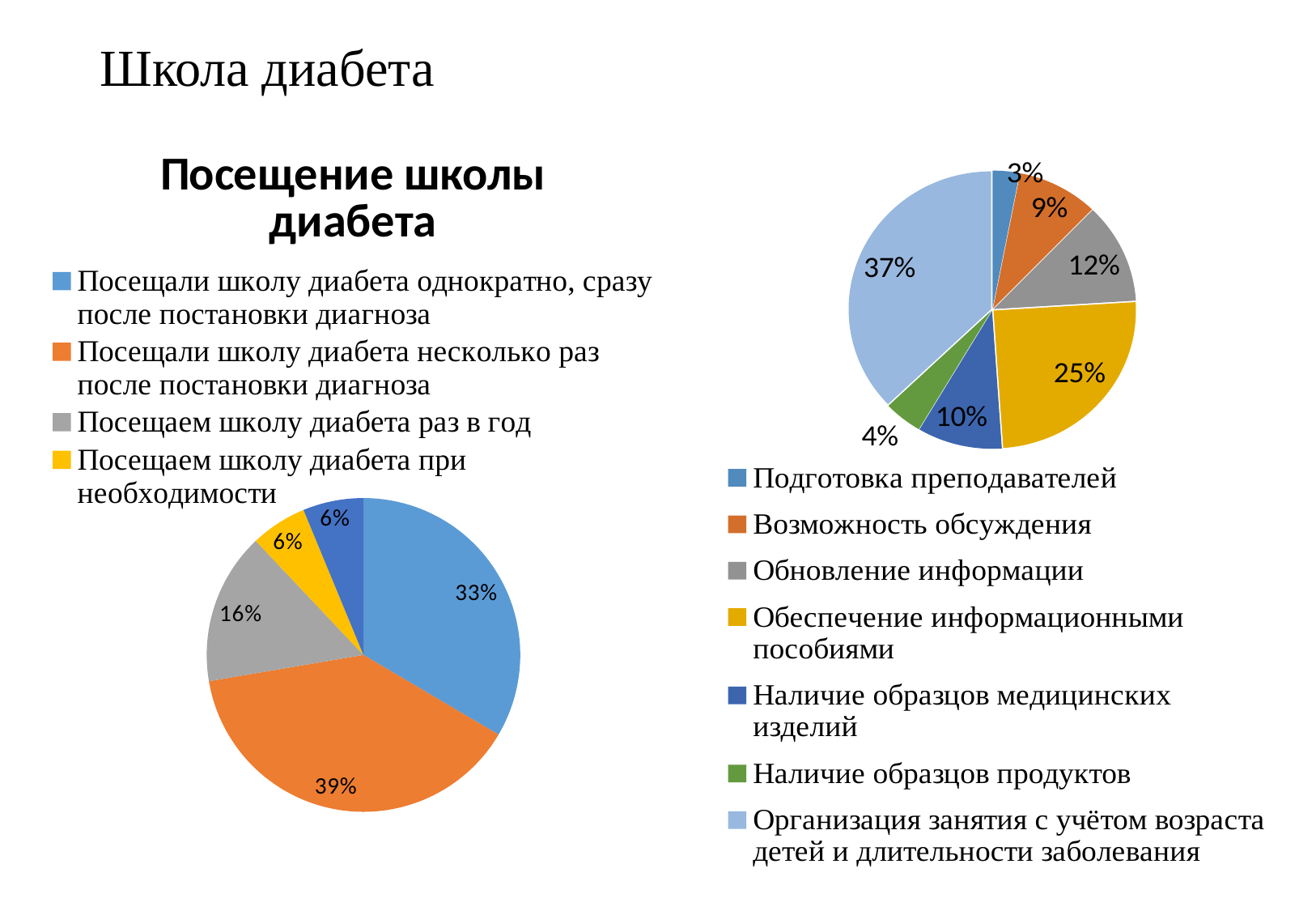
In the pie chart on the right side of the slide, which is larger: "Обновление информации" or "Наличие образцов медицинских изделий"? Обновление информации In the left chart titled "Посещение школы диабета", how many slices does the pie have? 5 In the pie chart on the right side of the slide, what share is shown for "Обеспечение информационными пособиями"? 25% How many entries does the legend of the pie chart on the right side of the slide list? 7 In the pie chart on the right side of the slide, which category has the largest slice? Организация занятия с учётом возраста детей и длительности заболевания In the left chart titled "Посещение школы диабета", what share is shown for "Посещаем школу диабета раз в год"? 16% In the pie chart on the right side of the slide, which category has the smallest slice? Подготовка преподавателей What type of chart is the chart on the right side of the slide? Pie chart In the left chart titled "Посещение школы диабета", what share is shown for "Посещали школу диабета несколько раз после постановки диагноза"? 39% In the left chart titled "Посещение школы диабета", what is the difference between the slices for "Посещали школу диабета несколько раз после постановки диагноза" and "Посещали школу диабета однократно, сразу после постановки диагноза"? 6% In the pie chart on the right side of the slide, what share is shown for "Наличие образцов продуктов"? 4% In the left chart titled "Посещение школы диабета", which category has the largest slice? Посещали школу диабета несколько раз после постановки диагноза